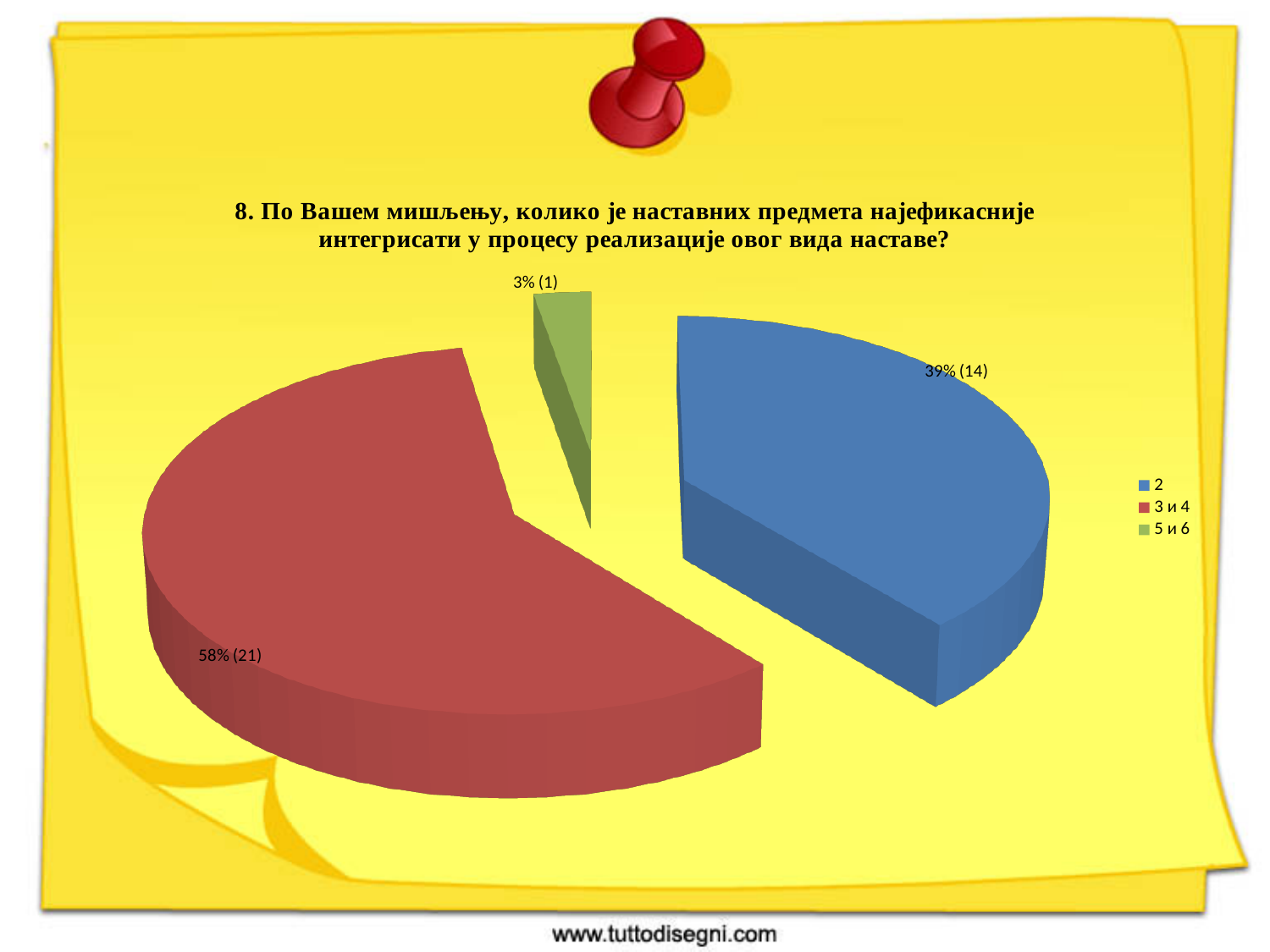
Which category has the largest share of the pie? 3 и 4 How many responses (the count in parentheses) does the "2" slice represent? 14 What percentage is shown for the "2" slice? 39% How many slices does the pie chart have? 3 Which colour represents the "5 и 6" category in the legend? green What percentage is shown for the "3 и 4" slice? 58% How many entries does the legend list? 3 What percentage is shown for the "5 и 6" slice? 3% What kind of chart is shown on the slide? pie chart Which category has the smallest share of the pie? 5 и 6 What is the difference in percentage points between the "3 и 4" slice and the "2" slice? 19 How many responses (the count in parentheses) does the "3 и 4" slice represent? 21